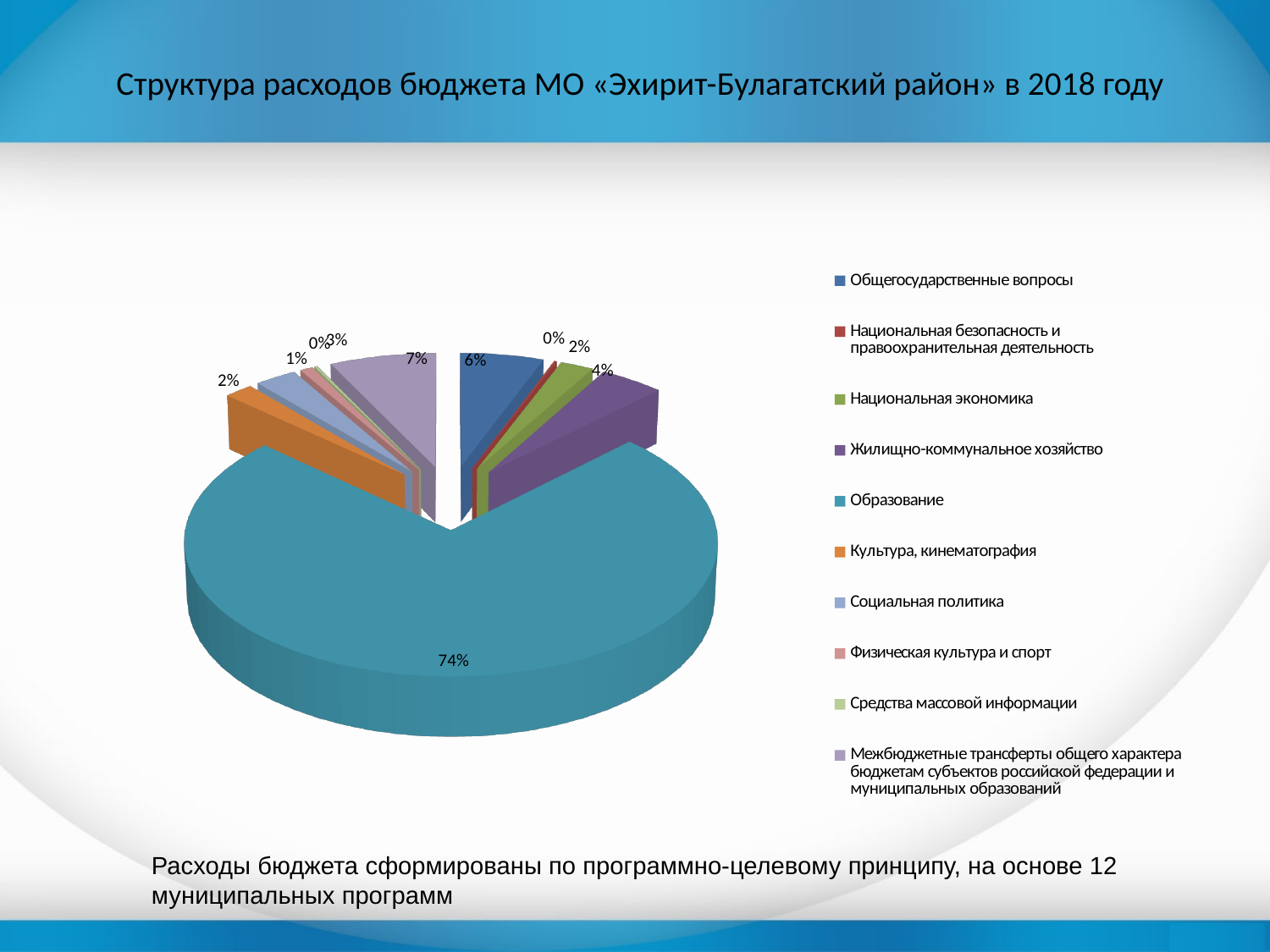
What share of the pie does Жилищно-коммунальное хозяйство have? 4% What share of the pie does Социальная политика have? 3% What share of the pie does Межбюджетные трансферты общего характера бюджетам субъектов российской федерации и муниципальных образований have? 7% Which is larger: the share for Общегосударственные вопросы or the share for Жилищно-коммунальное хозяйство? Общегосударственные вопросы What is the title of the slide containing the chart? Структура расходов бюджета МО «Эхирит-Булагатский район» в 2018 году What kind of chart is shown on the slide? pie chart What colour is the slice for Культура, кинематография? orange How many categories does the legend list? 10 Which category has the largest share of the pie? Образование What is the difference in percentage points between the share for Образование and the share for Межбюджетные трансферты общего характера? 67